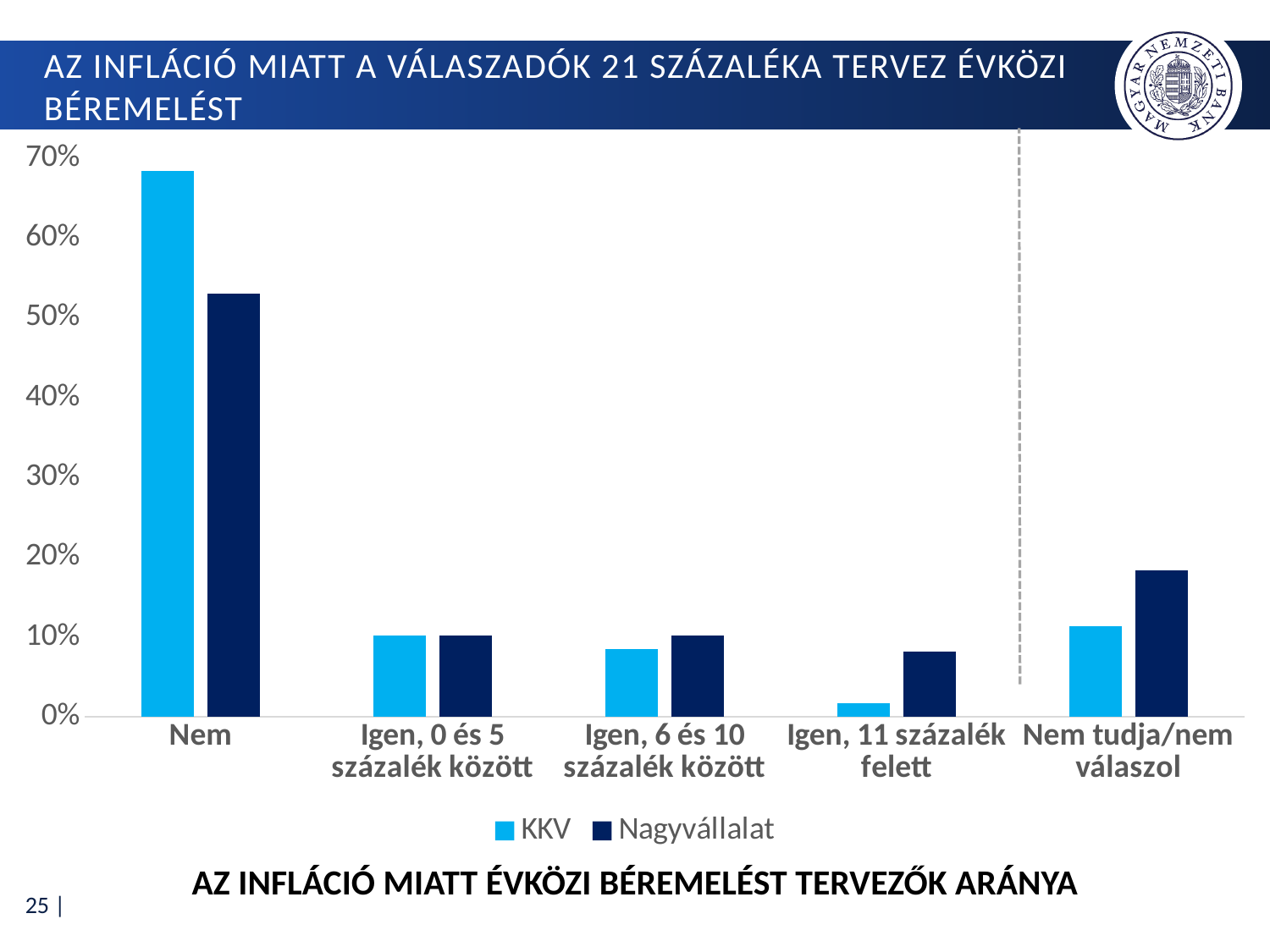
What are the two series named in the legend? KKV and Nagyvállalat Is the KKV value for 'Nem' greater or less than 60%? greater For the category 'Nem', which series has the larger value, KKV or Nagyvállalat? KKV Which category has the lowest value for the KKV series? Igen, 11 százalék felett Is the KKV value for 'Igen, 11 százalék felett' greater or less than 10%? less Which category has the highest value for the KKV series? Nem Is the Nagyvállalat value for 'Nem' greater or less than 60%? less Which category has the lowest value for the Nagyvállalat series? Igen, 11 százalék felett How many categories are shown on the x axis? 5 How many series does the legend list? 2 For the category 'Nem tudja/nem válaszol', which series has the larger value, KKV or Nagyvállalat? Nagyvállalat What kind of chart is shown on the slide? bar chart